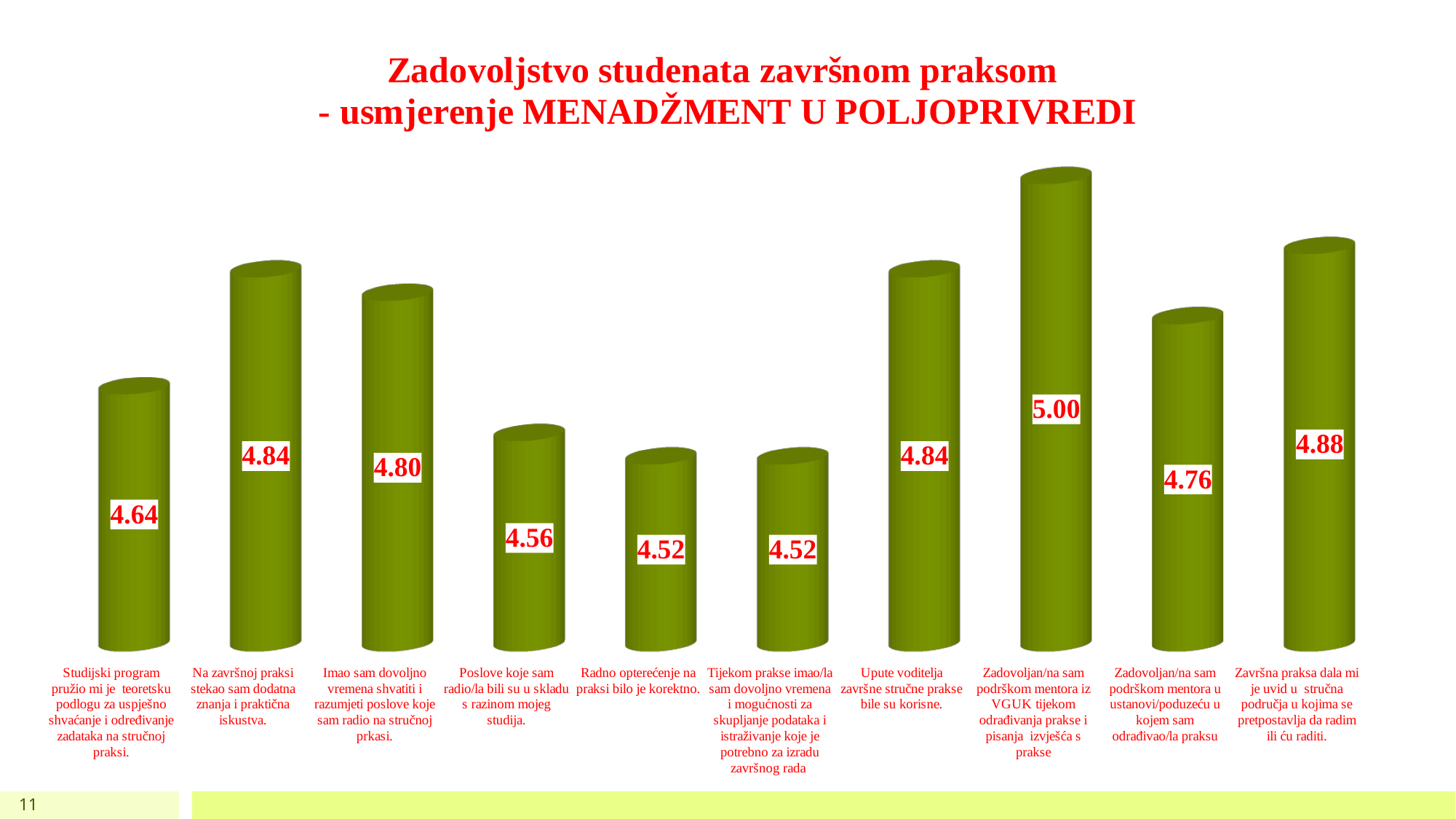
What kind of chart is shown on the slide? bar chart What is the difference between the highest value (5.00) and the value for "Studijski program pružio mi je teoretsku podlogu..." (4.64)? 0.36 Which is larger: the value for "Na završnoj praksi stekao sam dodatna znanja i praktična iskustva." or for "Imao sam dovoljno vremena shvatiti i razumjeti poslove koje sam radio na stručnoj prkasi."? Na završnoj praksi stekao sam dodatna znanja i praktična iskustva. What is the difference between the values for "Završna praksa dala mi je uvid u stručna područja..." and "Zadovoljan/na sam podrškom mentora u ustanovi/poduzeću..."? 0.12 What is the value for "Studijski program pružio mi je teoretsku podlogu za uspješno shvaćanje i određivanje zadataka na stručnoj praksi."? 4.64 What is the value for "Poslove koje sam radio/la bili su u skladu s razinom mojeg studija."? 4.56 Which category has the highest value? Zadovoljan/na sam podrškom mentora iz VGUK tijekom odrađivanja prakse i pisanja izvješća s prakse What is the title of the chart? Zadovoljstvo studenata završnom praksom - usmjerenje MENADŽMENT U POLJOPRIVREDI What is the value for "Upute voditelja završne stručne prakse bile su korisne."? 4.84 How many bars (categories) does the chart show? 10 What is the value for "Zadovoljan/na sam podrškom mentora u ustanovi/poduzeću u kojem sam odrađivao/la praksu"? 4.76 What is the lowest value shown in the chart? 4.52